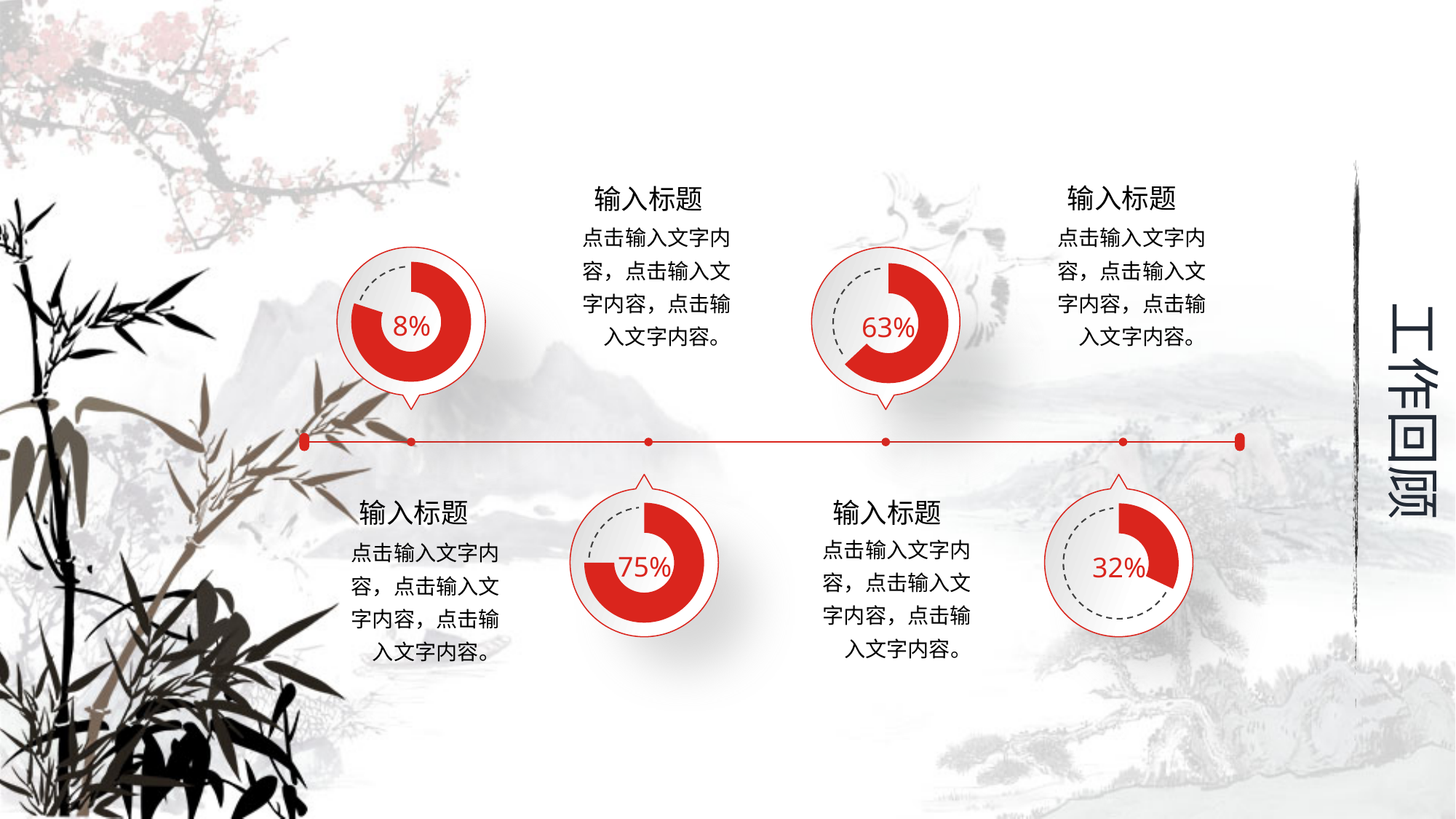
What is the difference between the percentage in the bottom-middle chart and the percentage in the top-right chart? 12% Which of the four donut charts shows the highest percentage? The bottom-middle chart (75%) What colour is the filled portion of each donut chart? Red How many donut charts are on the slide? 4 What percentage is shown in the top-left donut chart on the slide? 8% What percentage is shown in the bottom-middle donut chart on the slide? 75% Which is larger, the percentage in the top-right chart or the percentage in the bottom-right chart? The top-right chart (63%) What is the difference between the percentage in the top-right chart and the percentage in the bottom-right chart? 31% Which of the four donut charts shows the lowest percentage? The top-left chart (8%) What percentage is shown in the top-right donut chart on the slide? 63% What percentage is shown in the bottom-right donut chart on the slide? 32% What kind of chart is used to display the percentages on the slide? Donut chart